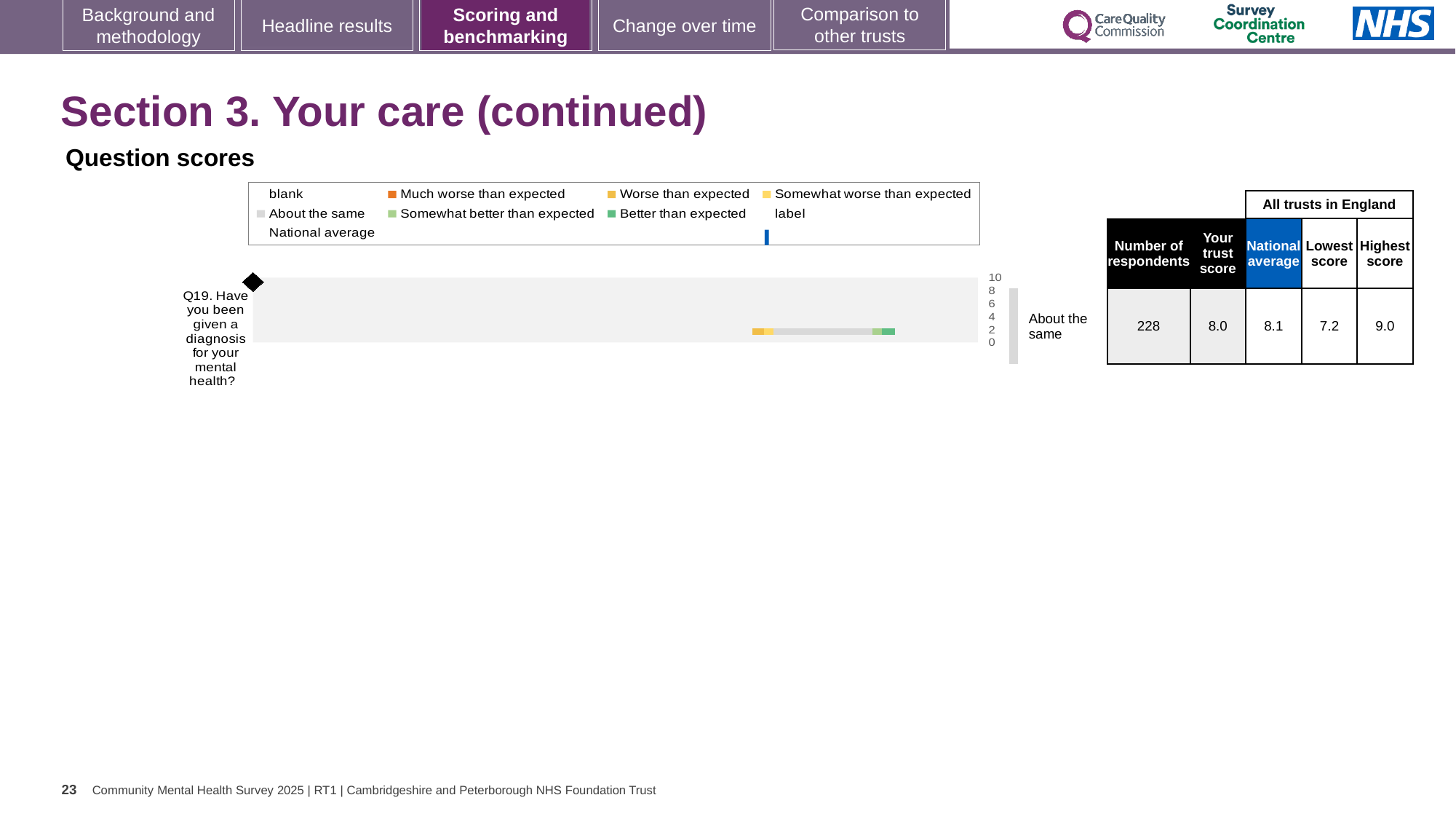
What is the highest score among all trusts in England for Q19? 9.0 What is the lowest score among all trusts in England for Q19? 7.2 How many questions are plotted in the question scores chart? 1 What is the difference between the highest score and the lowest score for Q19? 1.8 What benchmark category is shown next to the chart for Q19? About the same Which is larger for Q19, the trust score or the national average? national average Which question is plotted in the question scores chart? Q19. Have you been given a diagnosis for your mental health? What is the national average for Q19? 8.1 What is the maximum value shown on the chart's score axis? 10 What kind of chart is used to show the question scores on this slide? bar chart What is the trust score for Q19? 8.0 What is the number of respondents for Q19? 228